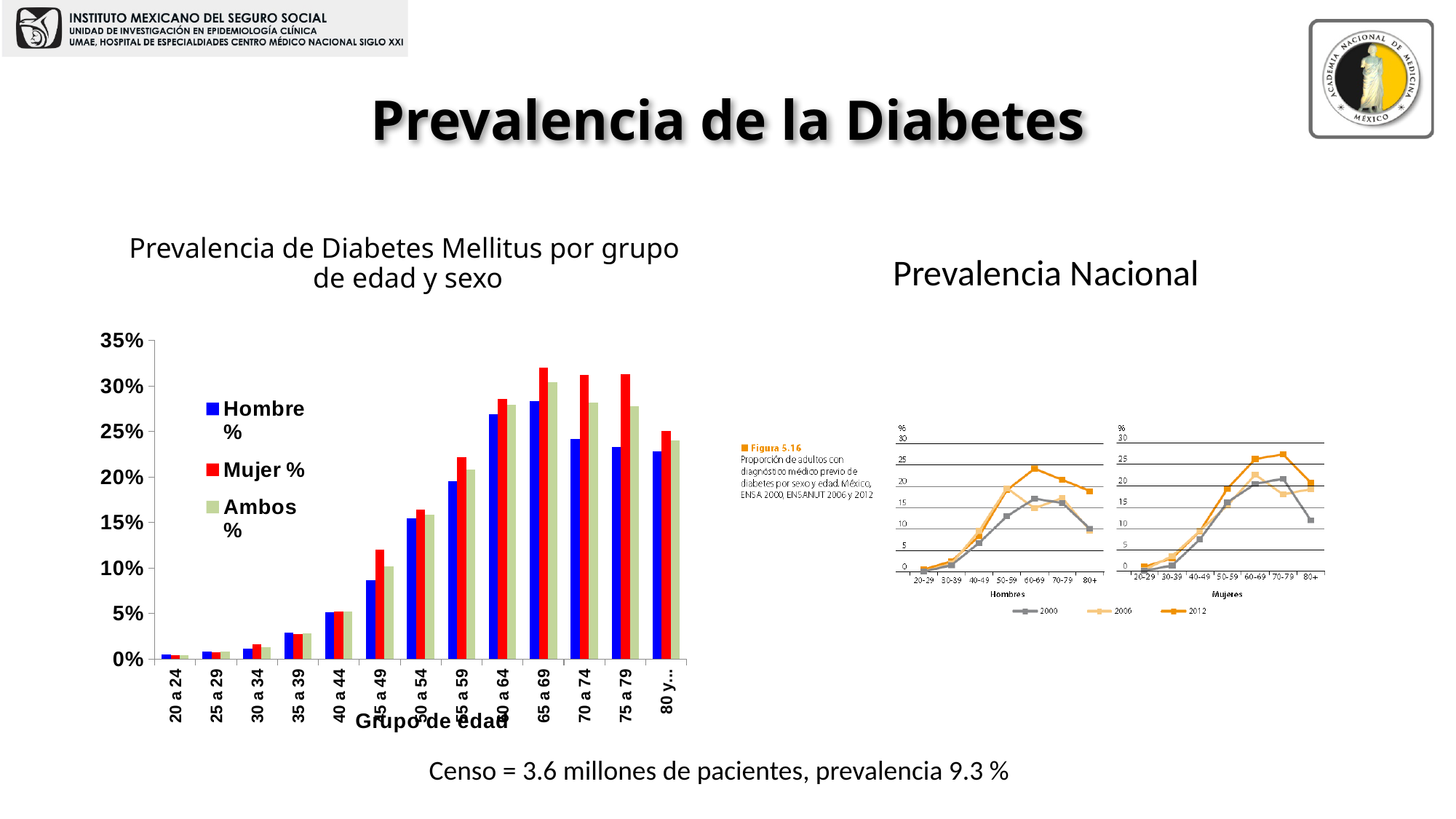
In the 'Prevalencia de Diabetes Mellitus por grupo de edad y sexo' chart, which age group has the lowest Ambos % value? 20 a 24 How many series does the legend of the 'Prevalencia Nacional' line charts list? 3 How many age groups are shown on the x axis of the 'Prevalencia de Diabetes Mellitus por grupo de edad y sexo' chart? 13 In the 'Prevalencia de Diabetes Mellitus por grupo de edad y sexo' chart, is the Hombre % value for 65 a 69 greater or less than 25%? greater In the 'Prevalencia de Diabetes Mellitus por grupo de edad y sexo' chart, is the Mujer % value for 45 a 49 greater or less than 10%? greater In the 'Prevalencia de Diabetes Mellitus por grupo de edad y sexo' chart, for the 70 a 74 age group, which is larger: Hombre % or Mujer %? Mujer % In the 'Prevalencia de Diabetes Mellitus por grupo de edad y sexo' chart, is the Ambos % value for 55 a 59 greater or less than 25%? less In the 'Prevalencia de Diabetes Mellitus por grupo de edad y sexo' chart, what colour are the Mujer % bars? red How many series does the legend of the 'Prevalencia de Diabetes Mellitus por grupo de edad y sexo' chart list? 3 What kind of chart is 'Prevalencia de Diabetes Mellitus por grupo de edad y sexo'? bar chart In the 'Prevalencia de Diabetes Mellitus por grupo de edad y sexo' chart, which age group has the highest Hombre % value? 65 a 69 In the 'Prevalencia de Diabetes Mellitus por grupo de edad y sexo' chart, do the Ambos % values rise or fall from 20 a 24 to 65 a 69? rise